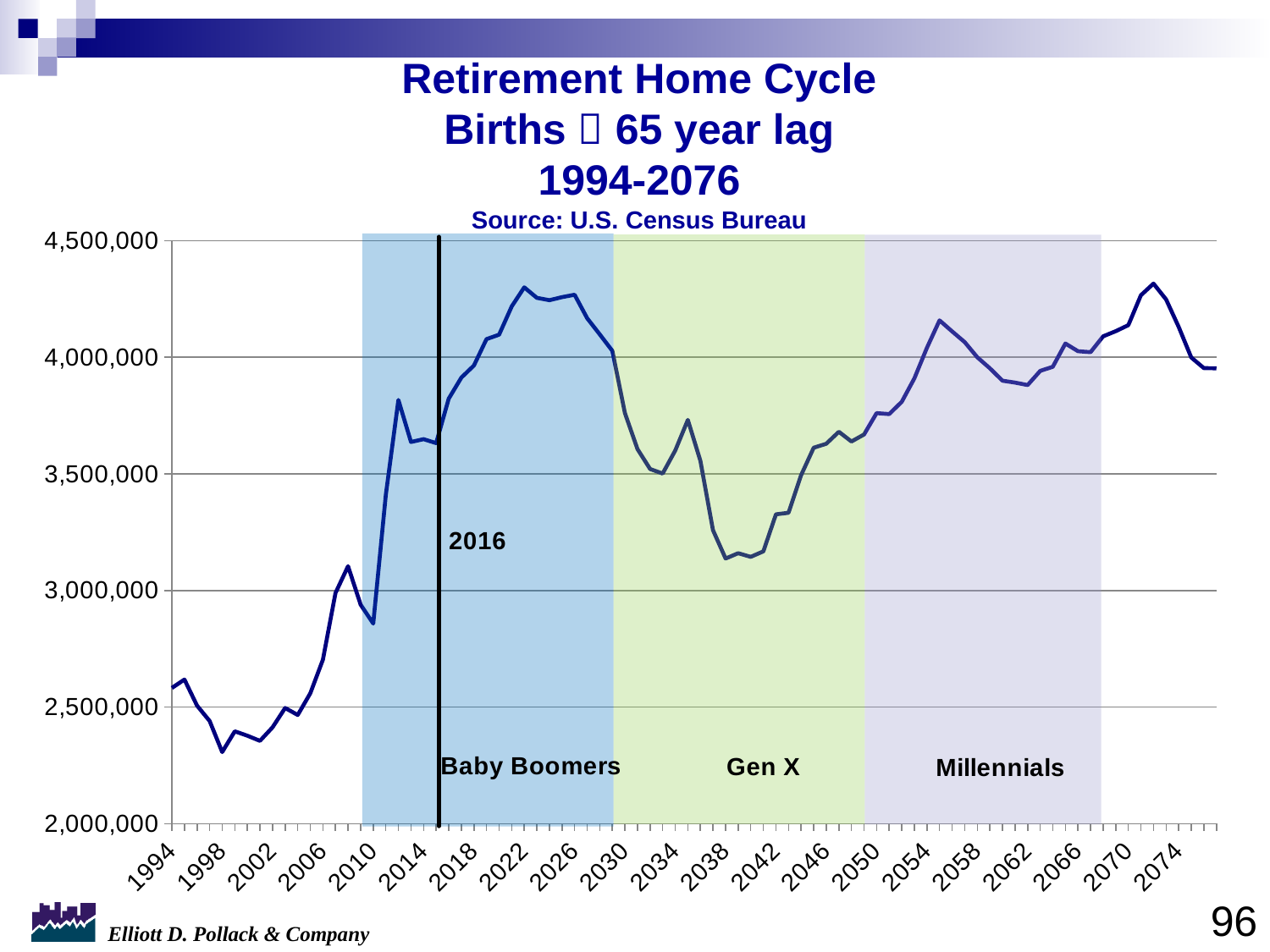
What is the title of the chart? Retirement Home Cycle Births – 65 year lag 1994-2076 What source is cited for the chart data? U.S. Census Bureau Is the value for 1998 greater or less than 2,500,000? less Do the values rise or fall between 2010 and 2022? rise Is the value for 2038 greater or less than 3,500,000? less Do the values rise or fall between 2030 and 2038? fall Is the value for 2010 greater or less than 3,000,000? less What kind of chart is shown on the slide? line chart